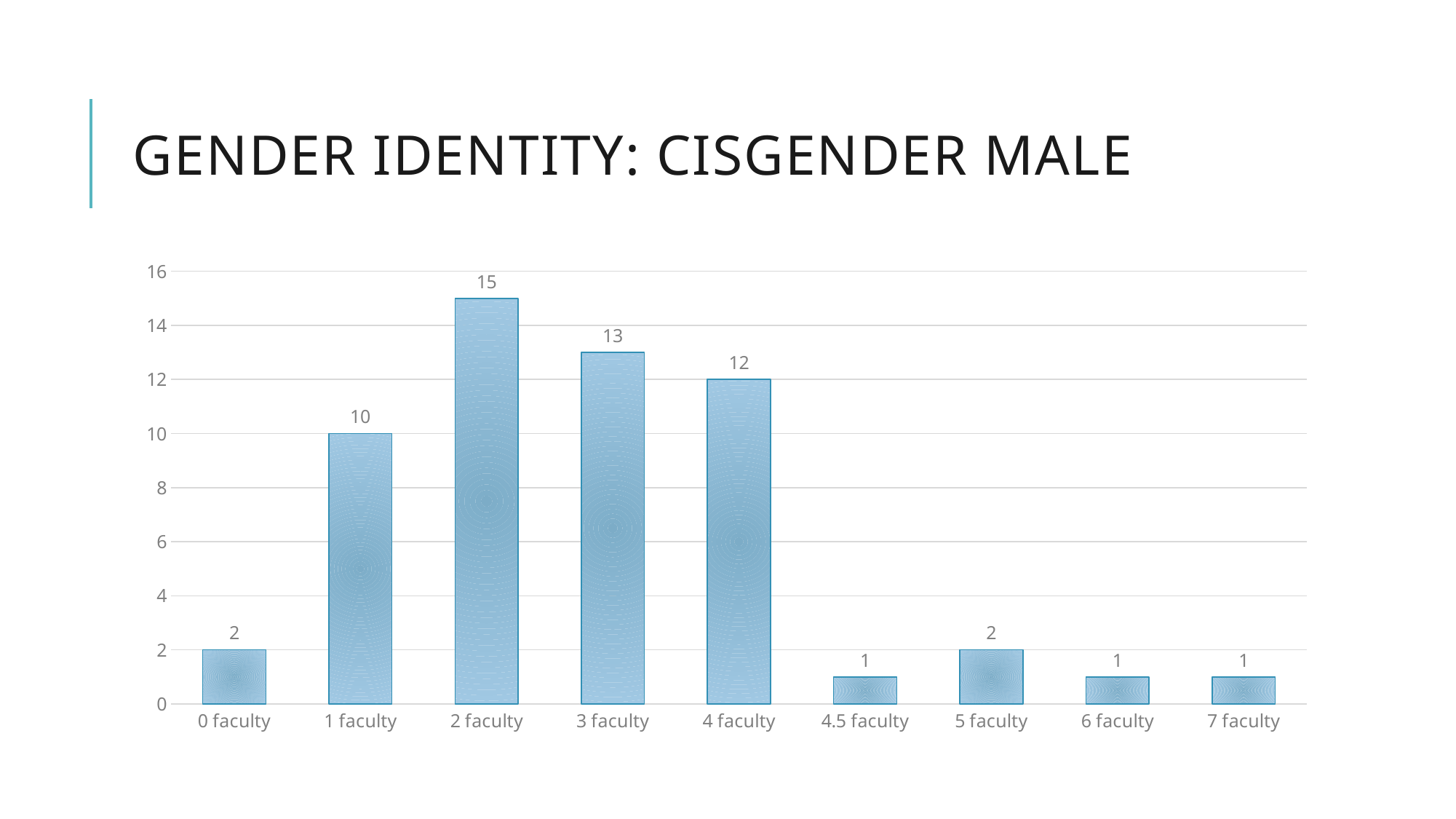
What is the difference between the values for 2 faculty and 3 faculty? 2 What is the title of the slide? GENDER IDENTITY: CISGENDER MALE How many categories are shown on the x axis? 9 Which is larger, the value for 3 faculty or the value for 4 faculty? 3 faculty Which category has the highest value? 2 faculty What is the value for 4 faculty? 12 What is the difference between the values for 1 faculty and 0 faculty? 8 Do the values rise or fall from 4 faculty to 4.5 faculty? fall Is the value for 1 faculty greater or less than 8? greater What is the value for 2 faculty? 15 What is the value for 4.5 faculty? 1 What kind of chart is shown on the slide? bar chart